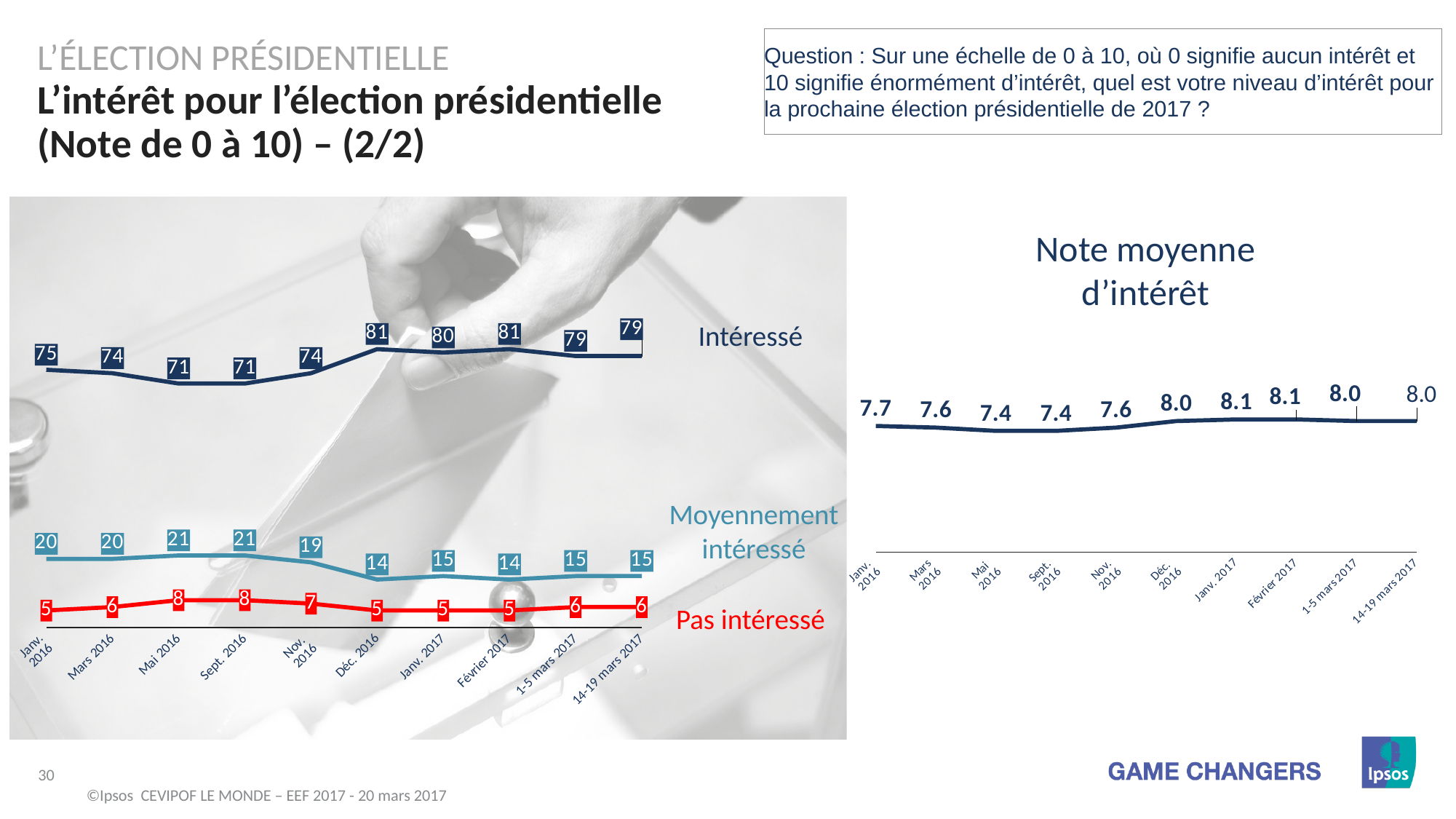
In the "Note moyenne d'intérêt" chart, what is the value for Janv. 2017? 8.1 In the "Note moyenne d'intérêt" chart, what is the lowest value shown? 7.4 In the left chart, what is the value for "Moyennement intéressé" in 14-19 mars 2017? 15 How many dates are plotted on the x axis of the left chart? 10 In the left chart, what is the difference between the "Intéressé" values in Janv. 2016 and Déc. 2016? 6 What type of chart is the "Note moyenne d'intérêt" chart? Line chart How many series does the left chart show? 3 In the left chart, what is the value for "Intéressé" in Déc. 2016? 81 In the left chart, what is the value for "Pas intéressé" in Mai 2016? 8 In the "Note moyenne d'intérêt" chart, what is the difference between the values for Mai 2016 and Février 2017? 0.7 In the left chart, at which date is the "Intéressé" series lowest? Mai 2016 and Sept. 2016 (71) In the left chart, which is larger: "Moyennement intéressé" in Sept. 2016 or in Déc. 2016? Sept. 2016